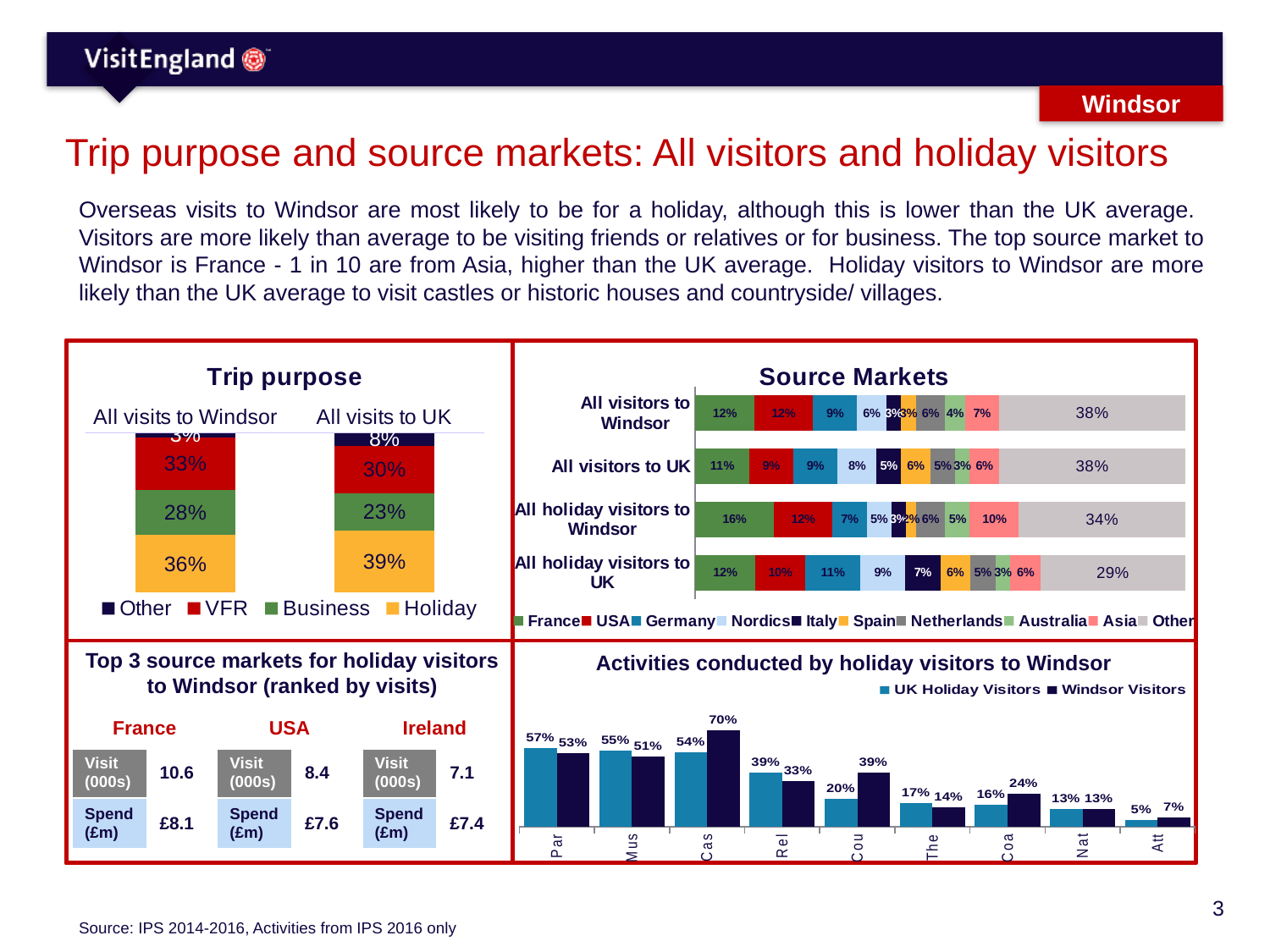
In the Trip purpose chart, what is the difference between the VFR share for all visits to Windsor and for all visits to the UK? 3% In the Source Markets chart, what share of all holiday visitors to Windsor come from France? 16% In the Activities conducted by holiday visitors to Windsor chart, what is the Windsor Visitors value for the third category from the left (labelled 'Cas')? 70% In the Trip purpose chart, how many series does the legend list? 4 In the Trip purpose chart, what percentage of all visits to Windsor are for Holiday? 36% In the Trip purpose chart, what percentage of all visits to the UK are for Business? 23% In the Activities conducted by holiday visitors to Windsor chart, how many activity categories are shown? 9 In the Source Markets chart, how many source market series does the legend list? 10 In the Activities conducted by holiday visitors to Windsor chart, which series has the higher value for the category labelled 'Cou': UK Holiday Visitors or Windsor Visitors? Windsor Visitors In the Source Markets chart, which bar has the smallest 'Other' share? All holiday visitors to UK In the Source Markets chart, what share of all visitors to Windsor come from Asia? 7% What type of chart is the Source Markets chart? Stacked bar chart